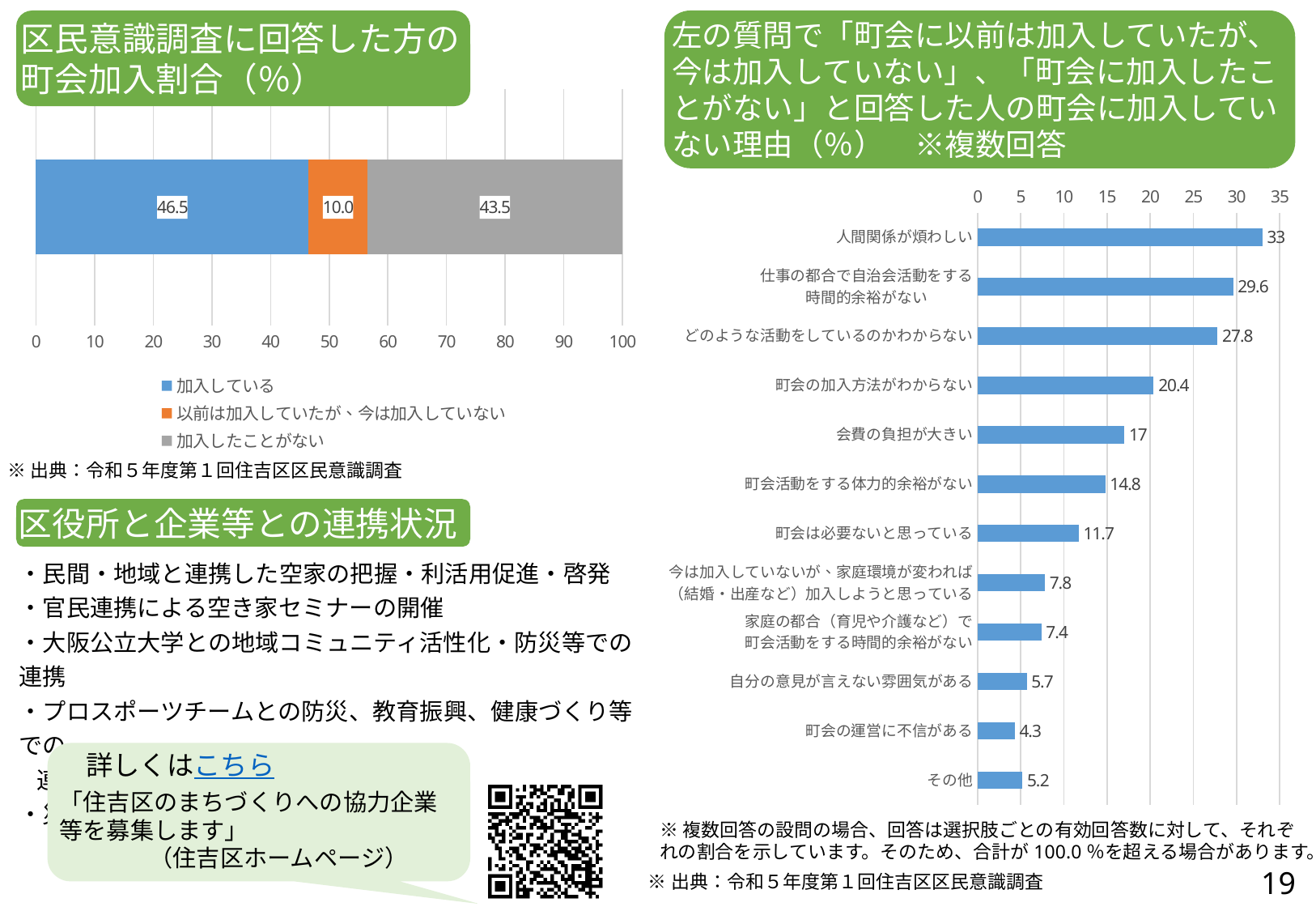
In the right chart (町会に加入していない理由), which reason has the highest value? 人間関係が煩わしい What kind of chart is the right chart (町会に加入していない理由)? Bar chart In the left chart (区民意識調査に回答した方の町会加入割合), what is the value for 加入したことがない? 43.5 In the left chart (区民意識調査に回答した方の町会加入割合), what is the value for 加入している? 46.5 In the right chart (町会に加入していない理由), what is the value for 人間関係が煩わしい? 33 In the right chart (町会に加入していない理由), which reason has the lowest value? 町会の運営に不信がある In the left chart (区民意識調査に回答した方の町会加入割合), what is the total of the stacked bar? 100.0 In the left chart (区民意識調査に回答した方の町会加入割合), which colour represents 以前は加入していたが、今は加入していない? Orange In the right chart (町会に加入していない理由), what is the difference between 町会の加入方法がわからない and 会費の負担が大きい? 3.4 In the left chart (区民意識調査に回答した方の町会加入割合), what is the difference between 加入している and 加入したことがない? 3.0 In the right chart (町会に加入していない理由), how many reason categories are plotted? 12 In the left chart (区民意識調査に回答した方の町会加入割合), how many series does the legend list? 3